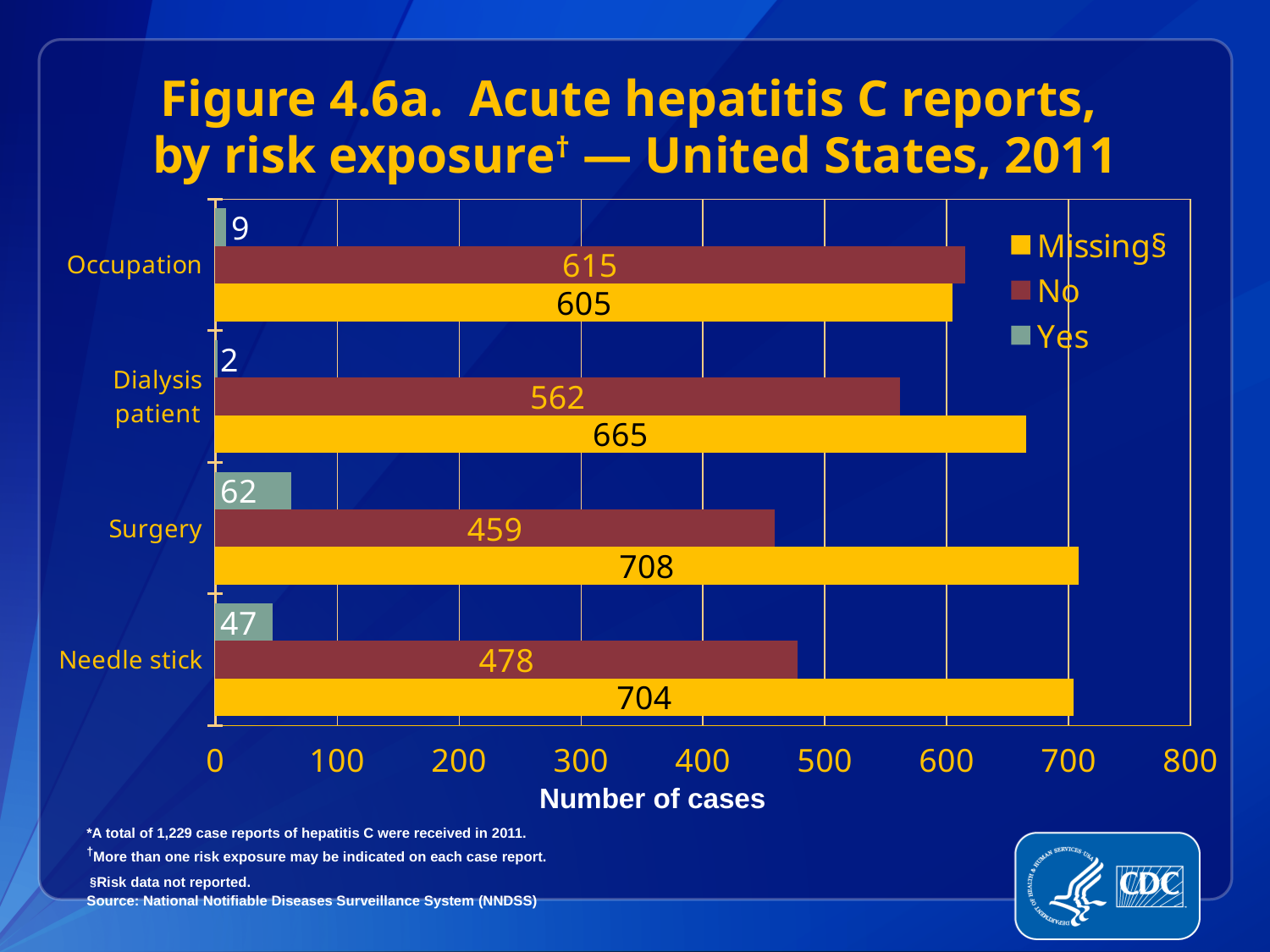
How many risk exposure categories are shown on the chart? 4 How many series does the legend list? 3 Is the No value for Needle stick greater or less than 500? less Which is larger for Dialysis patient: the No value or the Missing value? Missing Which risk exposure category has the lowest value in the Missing series? Occupation What is the number of cases for Dialysis patient in the No series? 562 What kind of chart is shown on the slide? Bar chart What is the number of cases for Occupation in the Yes series? 9 What is the difference between the No values for Occupation and Surgery? 156 What is the number of cases for Surgery in the Yes series? 62 What is the number of cases for Needle stick in the Missing series? 704 Which risk exposure category has the highest value in the Yes series? Surgery